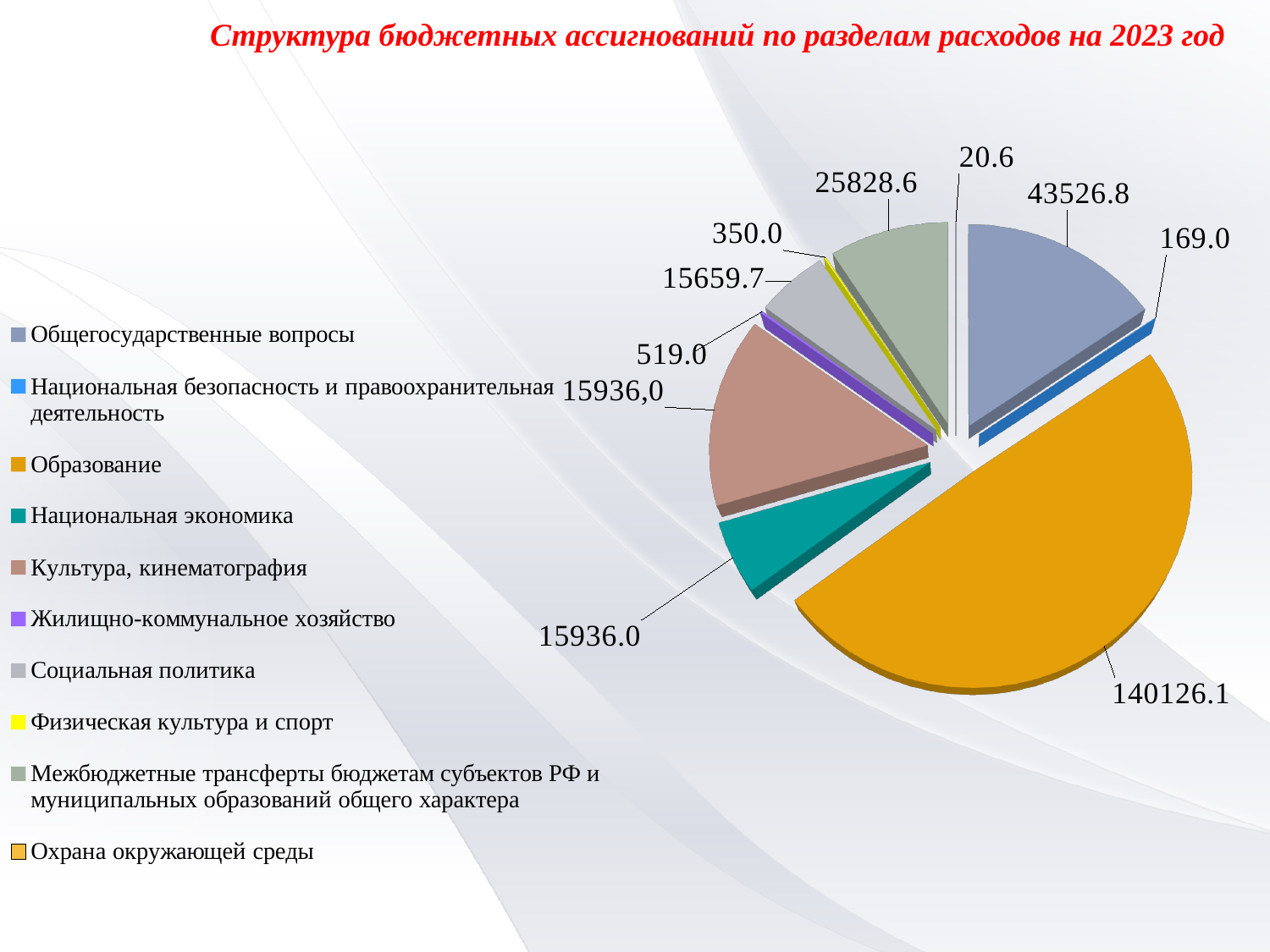
What is the value for Общегосударственные вопросы? 43526.8 What is the value for Физическая культура и спорт? 350.0 What is the value for Межбюджетные трансферты бюджетам субъектов РФ и муниципальных образований общего характера? 25828.6 Which category has the smallest value? Охрана окружающей среды What type of chart is shown on the slide? Pie chart Which is larger: Общегосударственные вопросы or Социальная политика? Общегосударственные вопросы What is the value for Образование? 140126.1 What is the value for Национальная безопасность и правоохранительная деятельность? 169.0 What is the value for Жилищно-коммунальное хозяйство? 519.0 How many categories does the legend list? 10 What is the value for Социальная политика? 15659.7 Which category has the largest slice of the pie? Образование